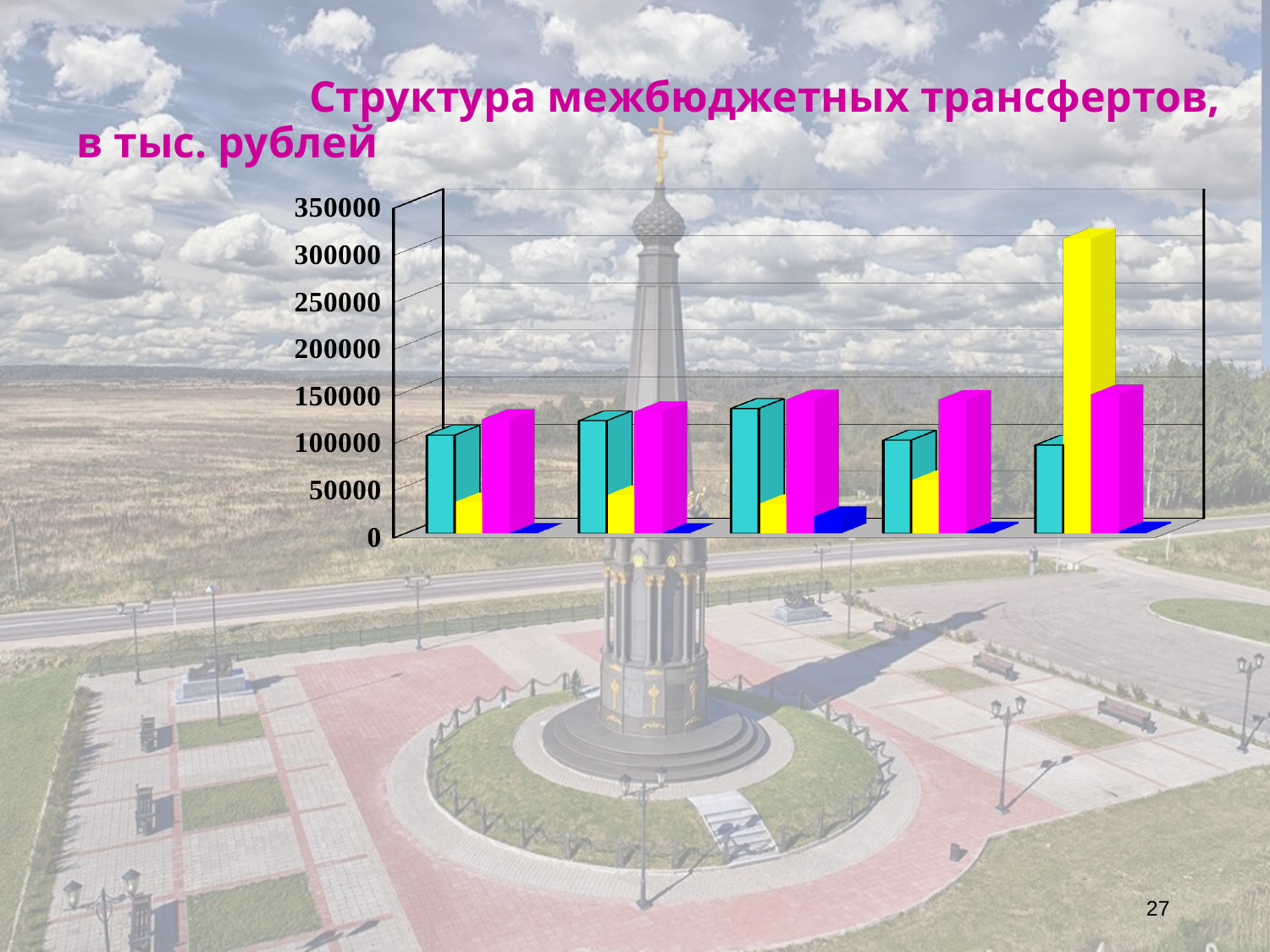
Is the magenta bar in the third group from the left greater or less than 100000? greater Which group of bars, counting from the left, contains the tallest bar on the chart? the fifth (rightmost) group Is the yellow bar in the rightmost group greater or less than 300000? greater How many differently coloured bar series appear in each group? 4 How many groups of bars are plotted along the x axis? 5 What kind of chart is shown on the slide? bar chart Is the dark blue bar in the third group from the left greater or less than 50000? less What is the title of the chart? Структура межбюджетных трансфертов, в тыс. рублей In the rightmost group, which is taller: the yellow bar or the magenta bar? the yellow bar What is the highest value shown on the vertical axis? 350000 Which is taller: the cyan bar in the third group from the left or the cyan bar in the rightmost group? the cyan bar in the third group